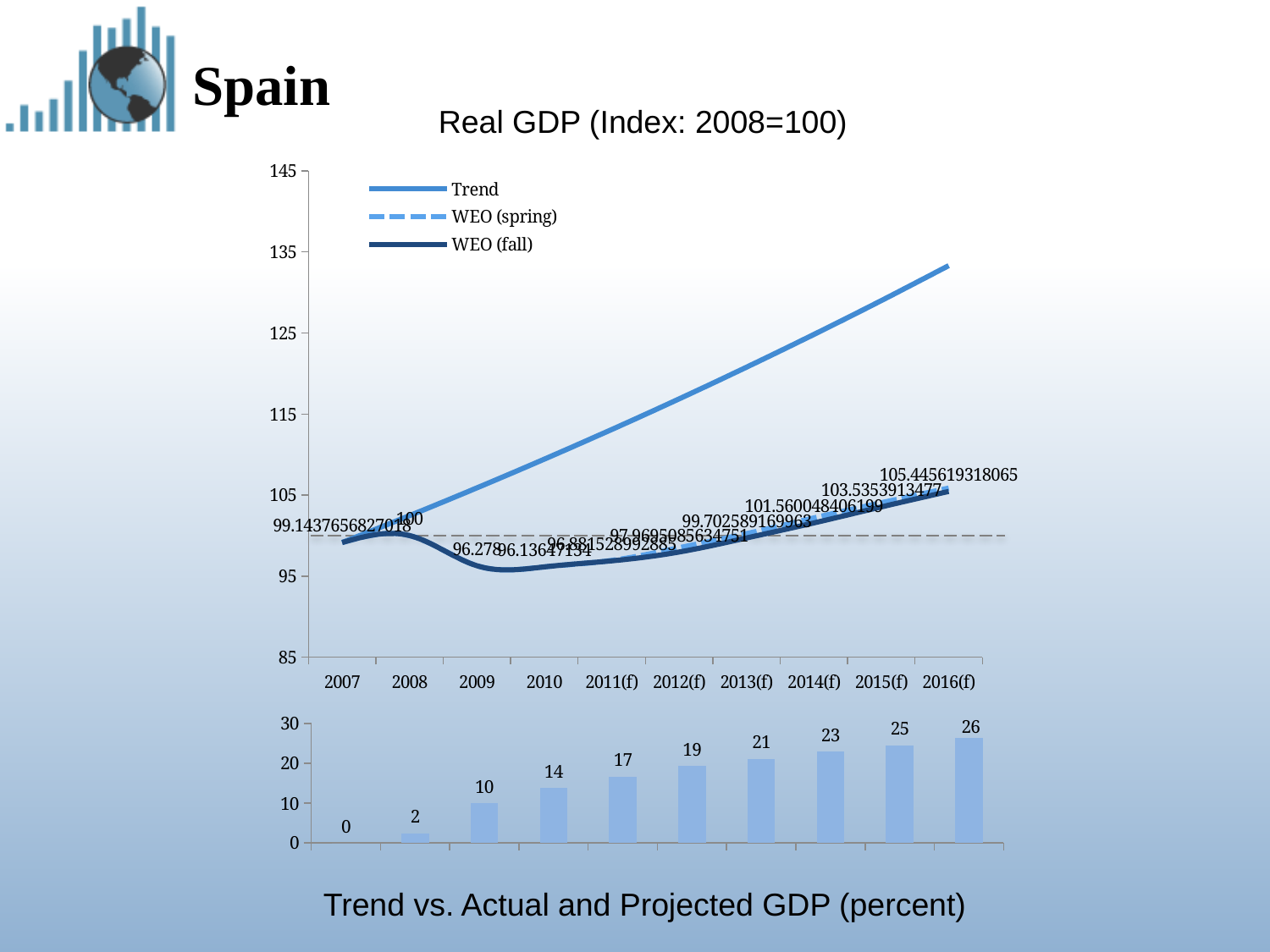
How many series does the legend of the top chart 'Real GDP (Index: 2008=100)' list? 3 In the bottom chart 'Trend vs. Actual and Projected GDP (percent)', what is the difference between the last bar (26) and the fifth bar (17)? 9 What kind of chart is the bottom chart titled 'Trend vs. Actual and Projected GDP (percent)'? bar chart In the top chart 'Real GDP (Index: 2008=100)', how many years are shown on the x axis? 10 In the top chart 'Real GDP (Index: 2008=100)', does the Trend series rise or fall from 2007 to 2016(f)? rise In the top chart 'Real GDP (Index: 2008=100)', is the Trend value for 2016(f) greater or less than 125? greater In the bottom chart 'Trend vs. Actual and Projected GDP (percent)', what is the value of the third bar from the left? 10 What kind of chart is the top chart titled 'Real GDP (Index: 2008=100)'? line chart In the bottom chart 'Trend vs. Actual and Projected GDP (percent)', what is the value of the tallest bar? 26 In the bottom chart 'Trend vs. Actual and Projected GDP (percent)', how many bars are plotted? 10 In the top chart 'Real GDP (Index: 2008=100)', what are the three series named in the legend? Trend, WEO (spring), WEO (fall) In the top chart 'Real GDP (Index: 2008=100)', is the WEO (fall) value for 2010 greater or less than 105? less